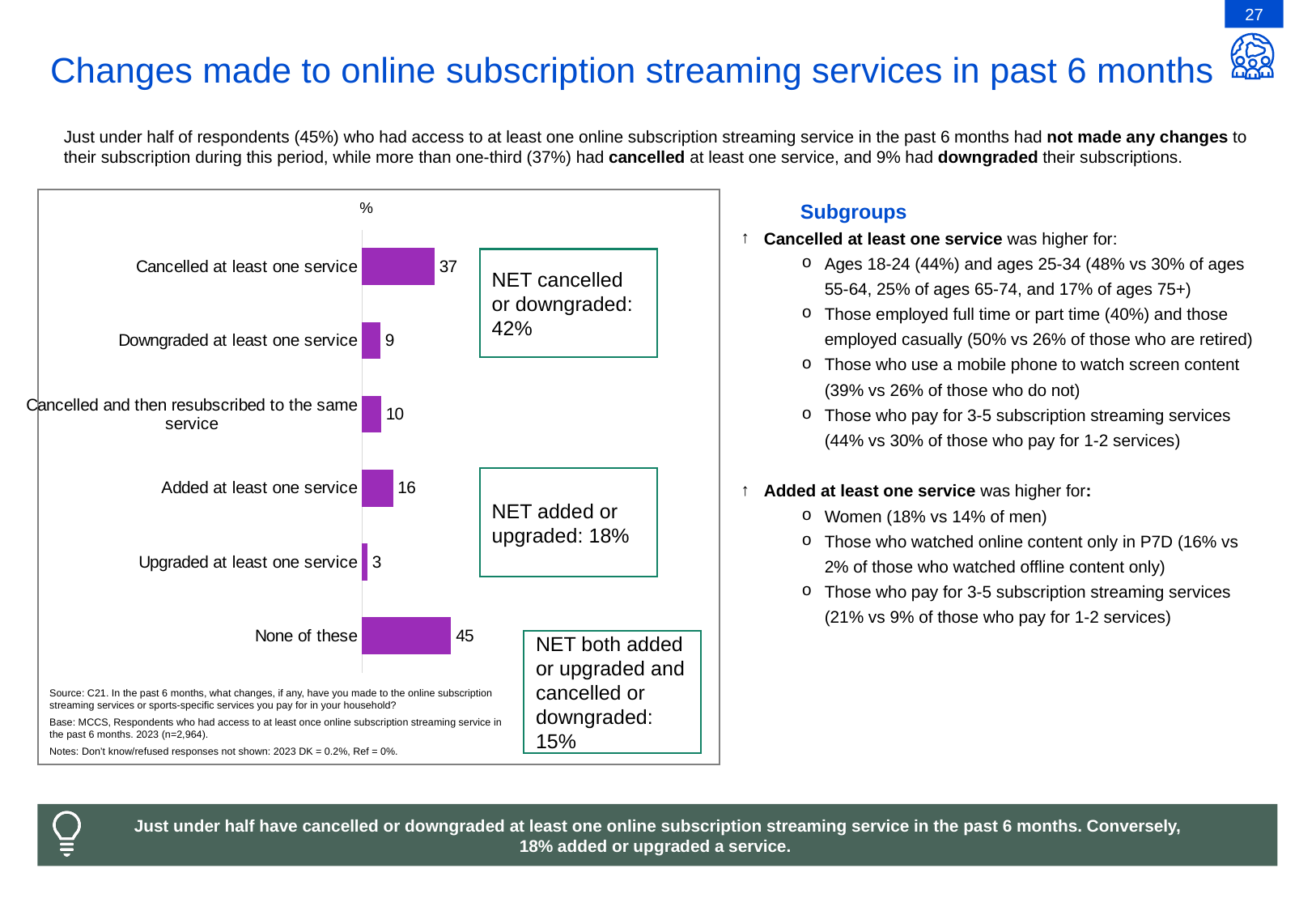
What is the value for "Downgraded at least one service"? 9 What is the value for "Cancelled at least one service"? 37 What kind of chart is shown on the slide? Bar chart What is the NET added or upgraded figure shown in the chart annotation? 18% Which category has the highest value? None of these Which is larger, the value for "Added at least one service" or "Cancelled and then resubscribed to the same service"? Added at least one service What is the value for "Upgraded at least one service"? 3 How many categories are shown in the chart? 6 What is the NET cancelled or downgraded figure shown in the chart annotation? 42% What is the difference between the values for "None of these" and "Cancelled at least one service"? 8 Which category has the lowest value? Upgraded at least one service What is the value for "Cancelled and then resubscribed to the same service"? 10